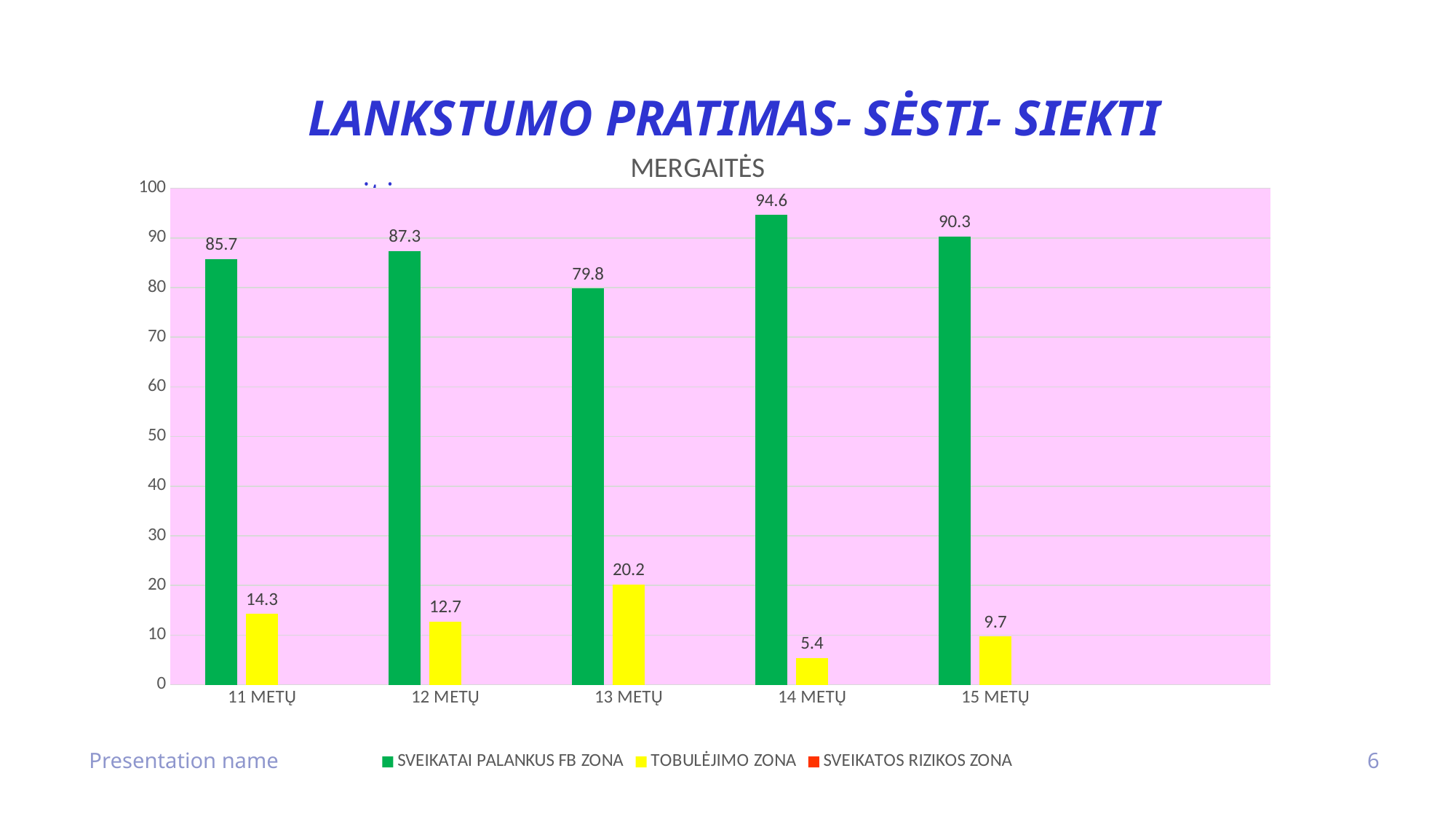
What is the difference between the SVEIKATAI PALANKUS FB ZONA values for 14 METŲ and 13 METŲ? 14.8 What kind of chart is shown on the slide? bar chart What is the value of TOBULĖJIMO ZONA for 13 METŲ? 20.2 Which is larger, the TOBULĖJIMO ZONA value for 11 METŲ or for 12 METŲ? 11 METŲ What is the value of SVEIKATAI PALANKUS FB ZONA for 14 METŲ? 94.6 Which age group has the lowest TOBULĖJIMO ZONA value? 14 METŲ Which age group has the highest SVEIKATAI PALANKUS FB ZONA value? 14 METŲ Is the SVEIKATAI PALANKUS FB ZONA value for 13 METŲ greater or less than 80? less How many series does the legend list? 3 What is the title of the chart? MERGAITĖS What is the value of SVEIKATAI PALANKUS FB ZONA for 11 METŲ? 85.7 How many age groups are shown on the x axis? 5